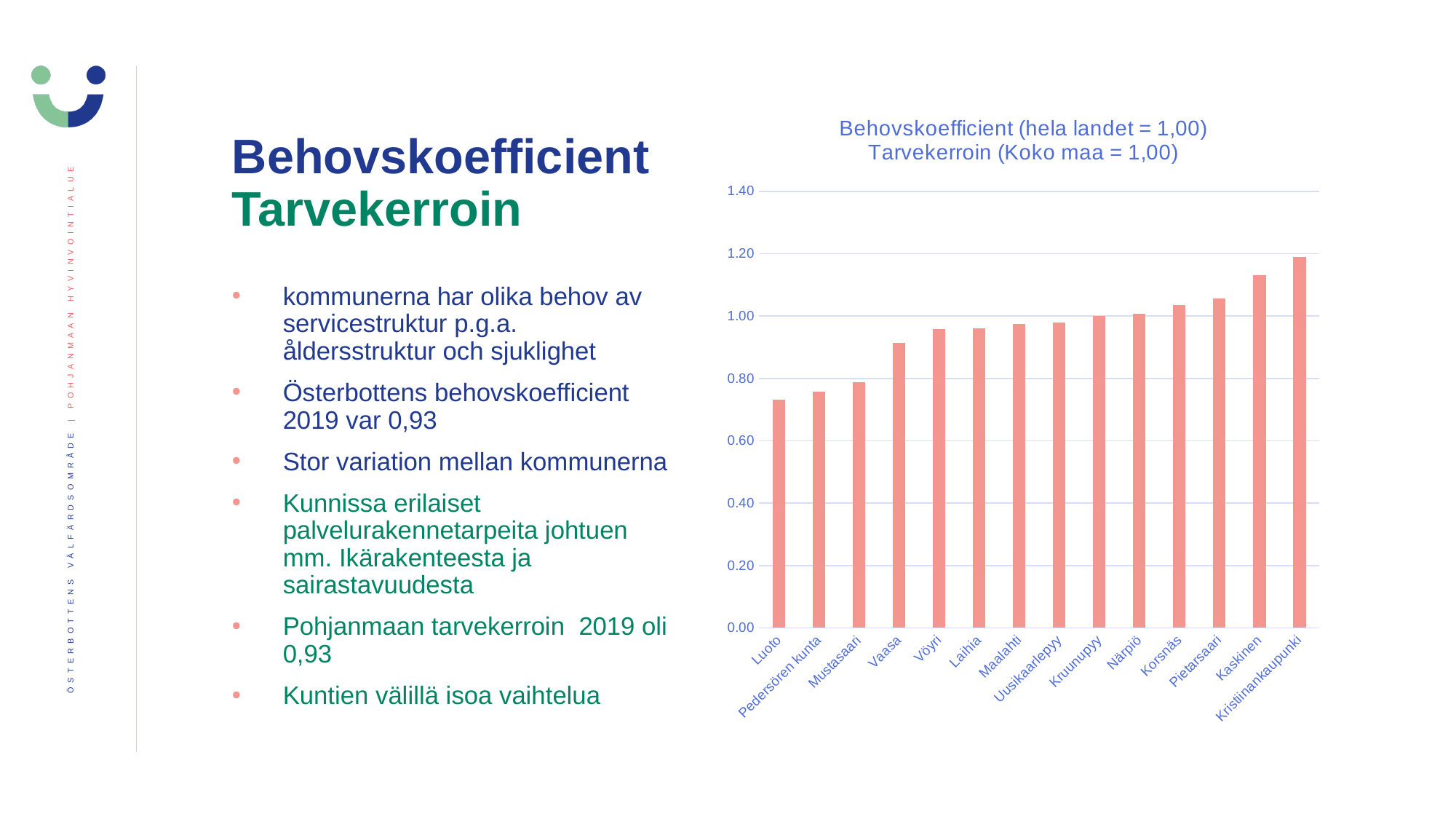
Is the value for Kristiinankaupunki greater or less than 1.00? greater What kind of chart is shown on the slide? bar chart What is the title of the chart? Behovskoefficient (hela landet = 1,00) Tarvekerroin (Koko maa = 1,00) Is the value for Luoto greater or less than 0.80? less Which municipality has the lowest value in the chart? Luoto Is the value for Vöyri greater or less than 1.00? less Which has the larger value, Kaskinen or Vaasa? Kaskinen Do the values rise or fall moving from left to right along the x axis? rise Which municipality has the highest value in the chart? Kristiinankaupunki How many municipalities (categories) are plotted in the chart? 14